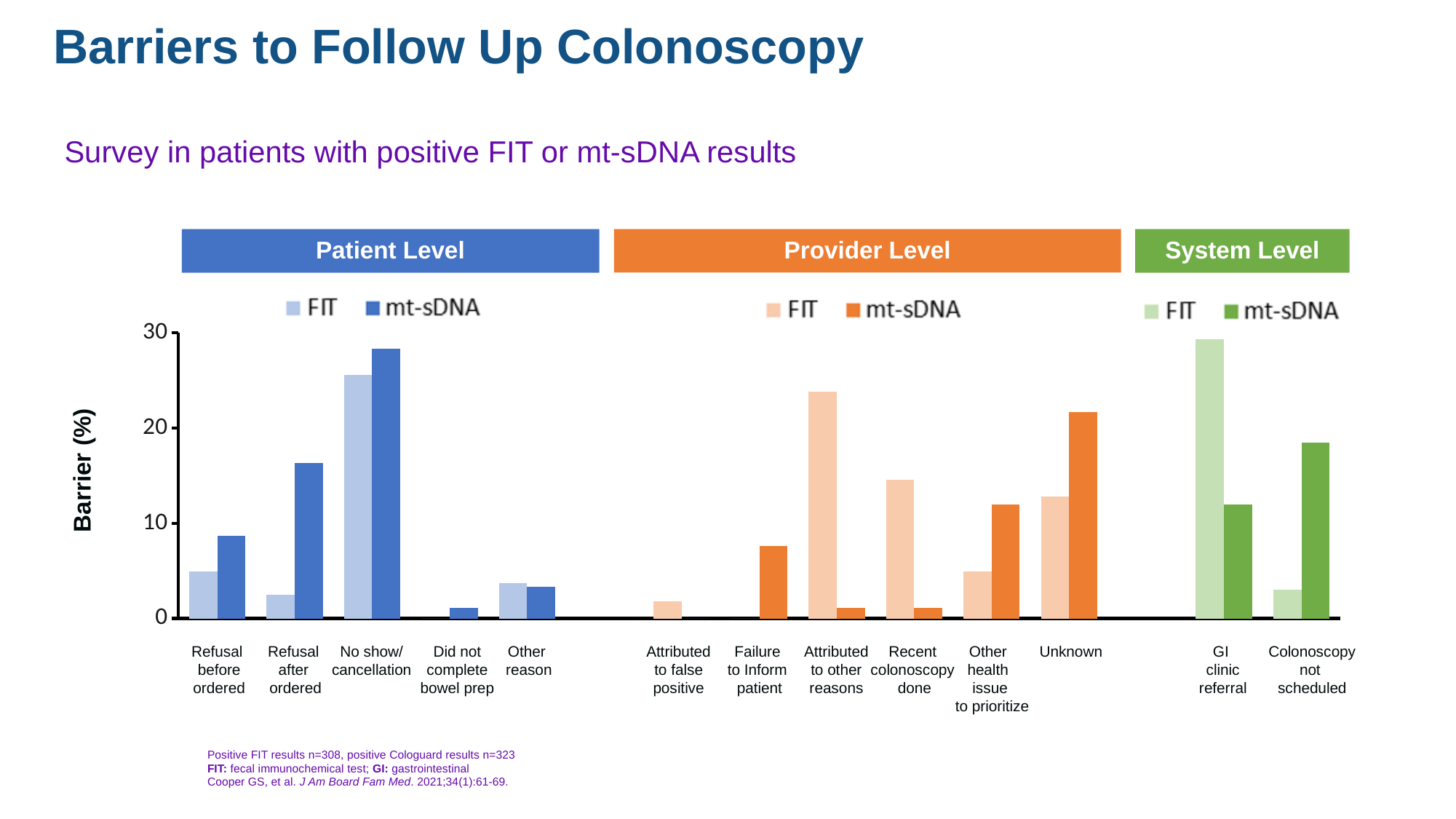
How many barrier categories are shown under the Provider Level section? 6 How many series does each legend on the chart list? 2 Which Provider Level category has the highest FIT value? Attributed to other reasons What kind of chart is shown on the slide? bar chart For Recent colonoscopy done, which is larger, the FIT value or the mt-sDNA value? FIT Is the mt-sDNA value for No show/cancellation greater or less than 20? greater Which Patient Level category has the highest mt-sDNA value? No show/cancellation Is the FIT value for GI clinic referral greater or less than 20? greater How many barrier categories are shown under the Patient Level section? 5 For Refusal after ordered, which is larger, the FIT value or the mt-sDNA value? mt-sDNA Is the mt-sDNA value for Failure to Inform patient greater or less than 10? less What is the label of the y axis? Barrier (%)